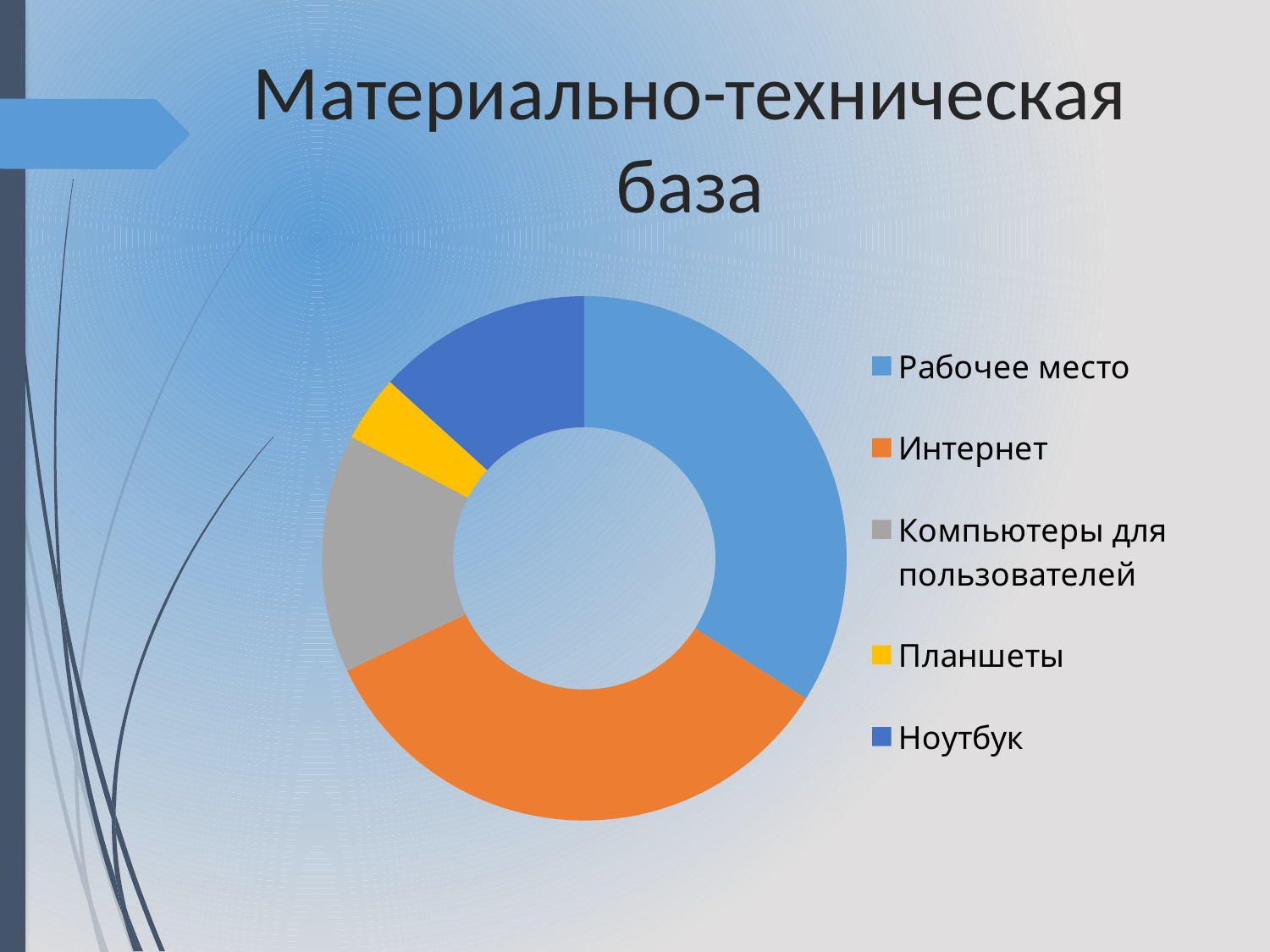
How many categories does the chart show? 5 Which is larger, the share for Планшеты or the share for Ноутбук? Ноутбук What kind of chart is shown on the slide? Doughnut (pie) chart Which is larger, the share for Рабочее место or the share for Планшеты? Рабочее место Which is larger, the share for Рабочее место or the share for Компьютеры для пользователей? Рабочее место Which category has the smallest share of the chart? Планшеты What is the title of the slide containing the chart? Материально-техническая база Which category is shown in yellow in the chart legend? Планшеты